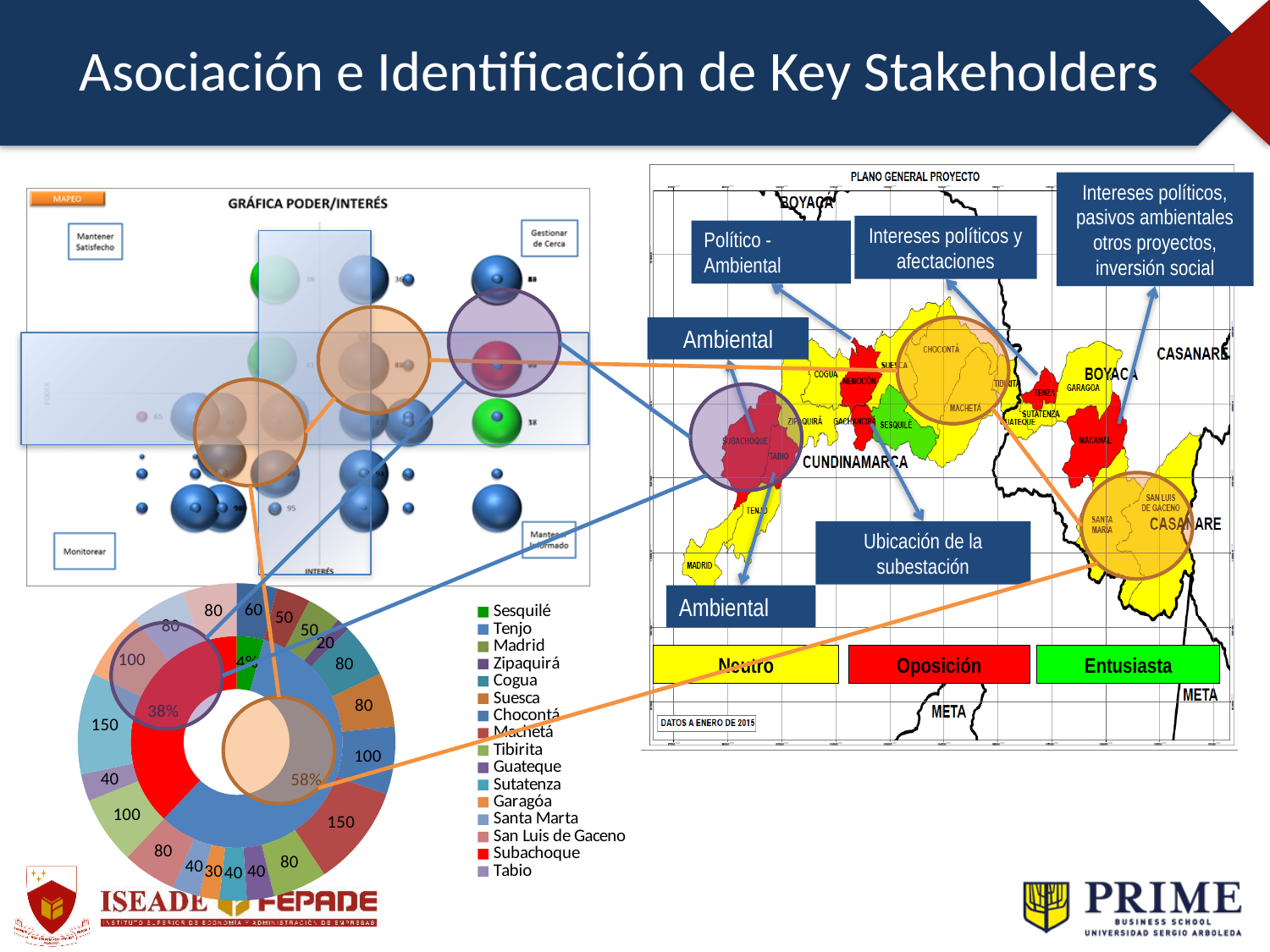
In the doughnut chart at the bottom left, what is the largest percentage shown on the inner ring? 58% What kind of chart is the chart at the bottom left of the slide with the legend of municipalities? doughnut chart How many entries does the legend of the doughnut chart at the bottom left list? 16 What is the title of the bubble chart on the left of the slide? GRÁFICA PODER/INTERÉS In the doughnut chart at the bottom left, what is the smallest percentage shown on the inner ring? 4% In the doughnut chart at the bottom left, which is larger: the inner-ring slice labelled 58% or the one labelled 38%? 58% Which legend entry of the doughnut chart at the bottom left is listed first? Sesquilé In the doughnut chart at the bottom left, what is the difference between the inner-ring slices labelled 58% and 38%? 20% What kind of chart is the chart titled GRÁFICA PODER/INTERÉS? bubble chart In the doughnut chart at the bottom left, what is the largest value labelled on the outer ring? 150 In the doughnut chart at the bottom left, what is the smallest value labelled on the outer ring? 20 What is the label of the horizontal axis of the chart titled GRÁFICA PODER/INTERÉS? INTERÉS